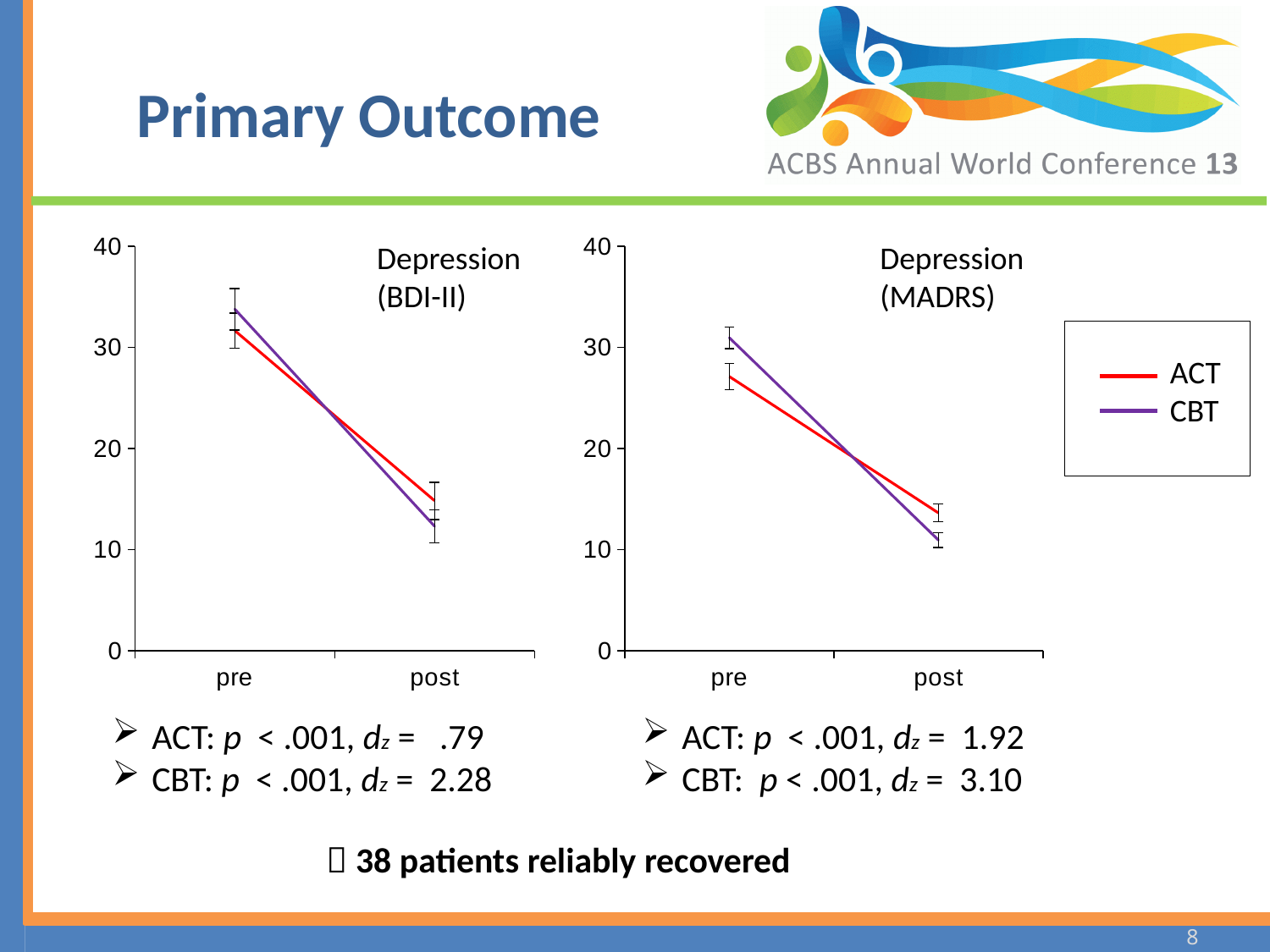
In the Depression (BDI-II) chart, do the ACT values rise or fall from pre to post? fall In the Depression (MADRS) chart, is the ACT value at pre greater or less than 30? less In the Depression (BDI-II) chart, is the ACT value at post greater or less than 10? greater What kind of chart is the Depression (BDI-II) chart? line chart How many series does the legend list? 2 What is the title of the chart on the right? Depression (MADRS) In the Depression (BDI-II) chart, is the CBT value at pre greater or less than 30? greater How many time points are shown on the x axis of the Depression (MADRS) chart? 2 Which series is drawn in red in the legend? ACT In the Depression (MADRS) chart, which series has the higher value at pre, ACT or CBT? CBT In the Depression (MADRS) chart, do the CBT values rise or fall from pre to post? fall